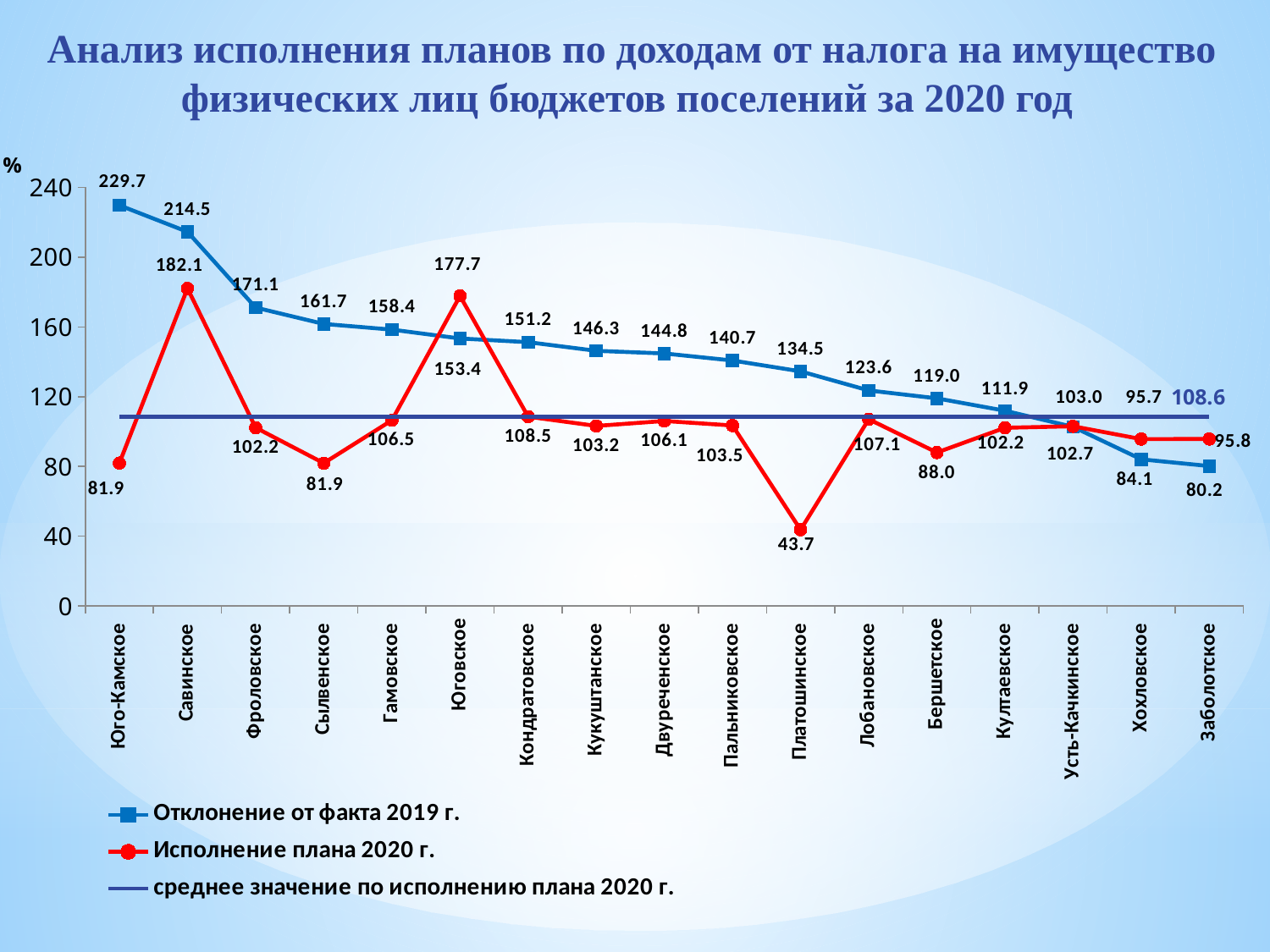
Which settlement has the lowest value of "Отклонение от факта 2019 г."? Заболотское Which is larger for Савинское: "Отклонение от факта 2019 г." or "Исполнение плана 2020 г."? Отклонение от факта 2019 г. What is the value of "Исполнение плана 2020 г." for Юговское? 177.7 What is the value of "Исполнение плана 2020 г." for Платошинское? 43.7 How many settlements are shown on the x axis? 17 What is the value of the average line "среднее значение по исполнению плана 2020 г."? 108.6 How many series does the legend list? 3 What is the difference between "Отклонение от факта 2019 г." and "Исполнение плана 2020 г." for Юго-Камское? 147.8 What kind of chart is shown on the slide? Line chart Does the "Отклонение от факта 2019 г." series rise or fall from left to right along the x axis? Fall What is the value of "Отклонение от факта 2019 г." for Юго-Камское? 229.7 Which settlement has the highest value of "Исполнение плана 2020 г."? Савинское